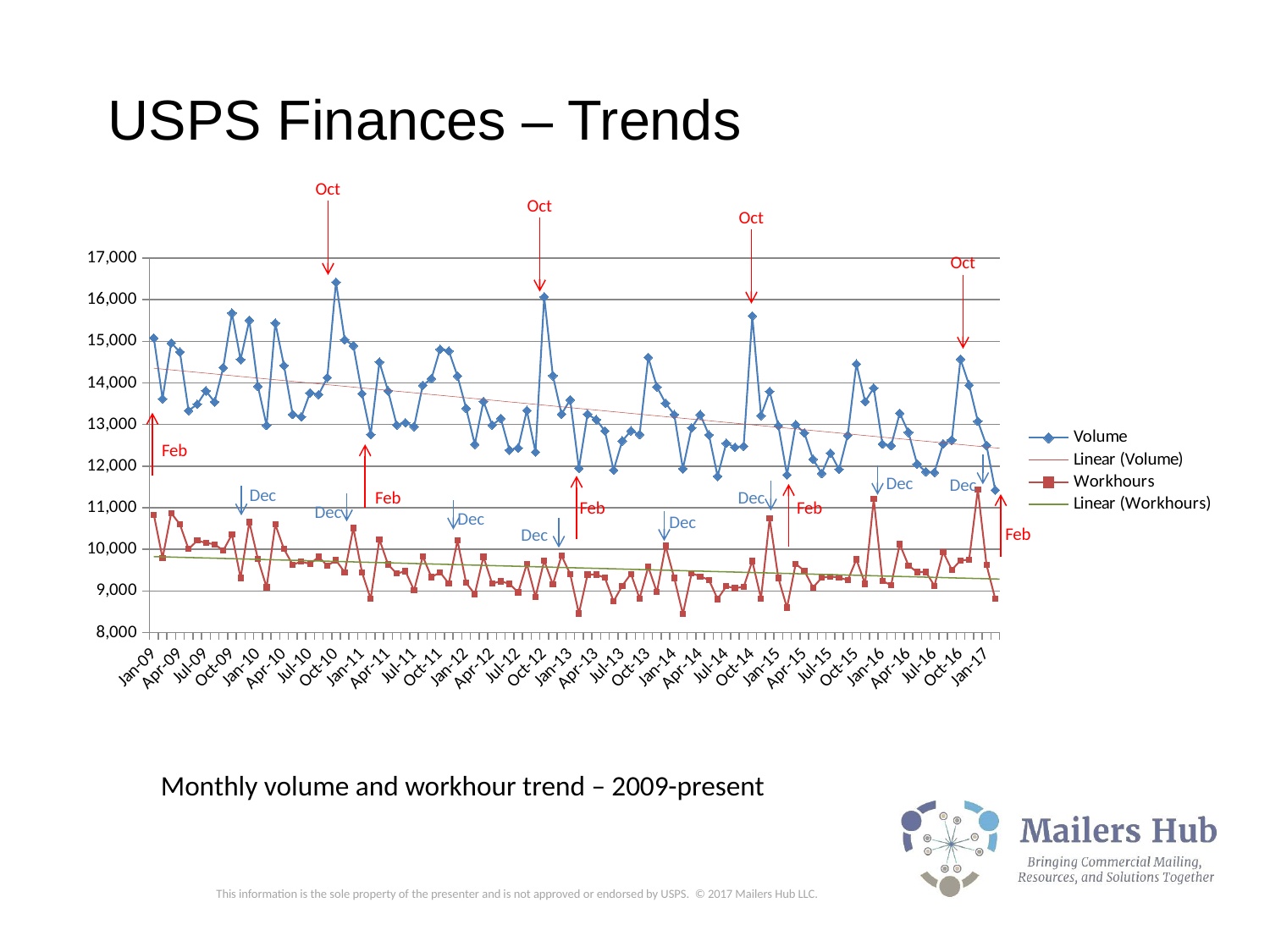
Is the Workhours value for Jan-09 greater or less than 10,000? greater Which month is annotated with red arrows as the recurring peak in Volume? Oct Does the linear trendline for Workhours rise or fall from left to right? fall Is the Volume value for Oct-14 greater or less than 15,000? greater Does the linear trendline for Volume rise or fall from left to right? fall What is the caption below the chart? Monthly volume and workhour trend – 2009-present How many entries does the chart legend list? 4 Is the Workhours value for Apr-13 greater or less than 9,000? greater What kind of chart is shown on the slide? line chart Which series has the higher values throughout the chart, Volume or Workhours? Volume